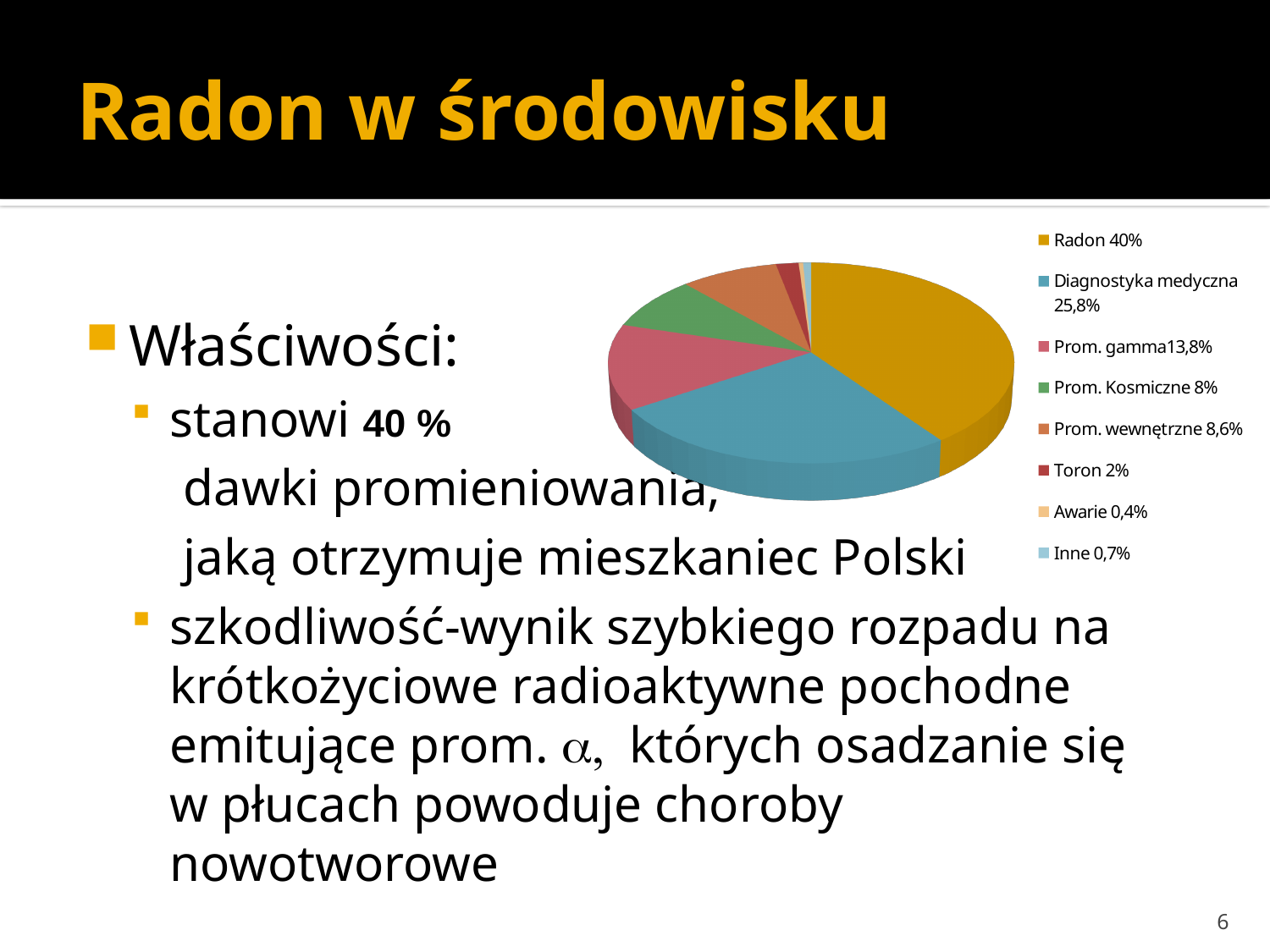
What kind of chart is shown on the slide? pie chart Which category has the largest slice of the pie? Radon Which category has the smallest share of the pie? Awarie What colour is the Radon slice in the pie chart? yellow/gold What is the difference between the Radon share and the Diagnostyka medyczna share? 14,2% Which is larger, Prom. wewnętrzne or Prom. Kosmiczne? Prom. wewnętrzne What value is given for Prom. wewnętrzne? 8,6% What value is given for Toron? 2% How many categories does the pie chart have? 8 What value is given for Diagnostyka medyczna in the legend? 25,8% What share of the pie does Radon account for? 40% Which is larger, Inne or Awarie? Inne